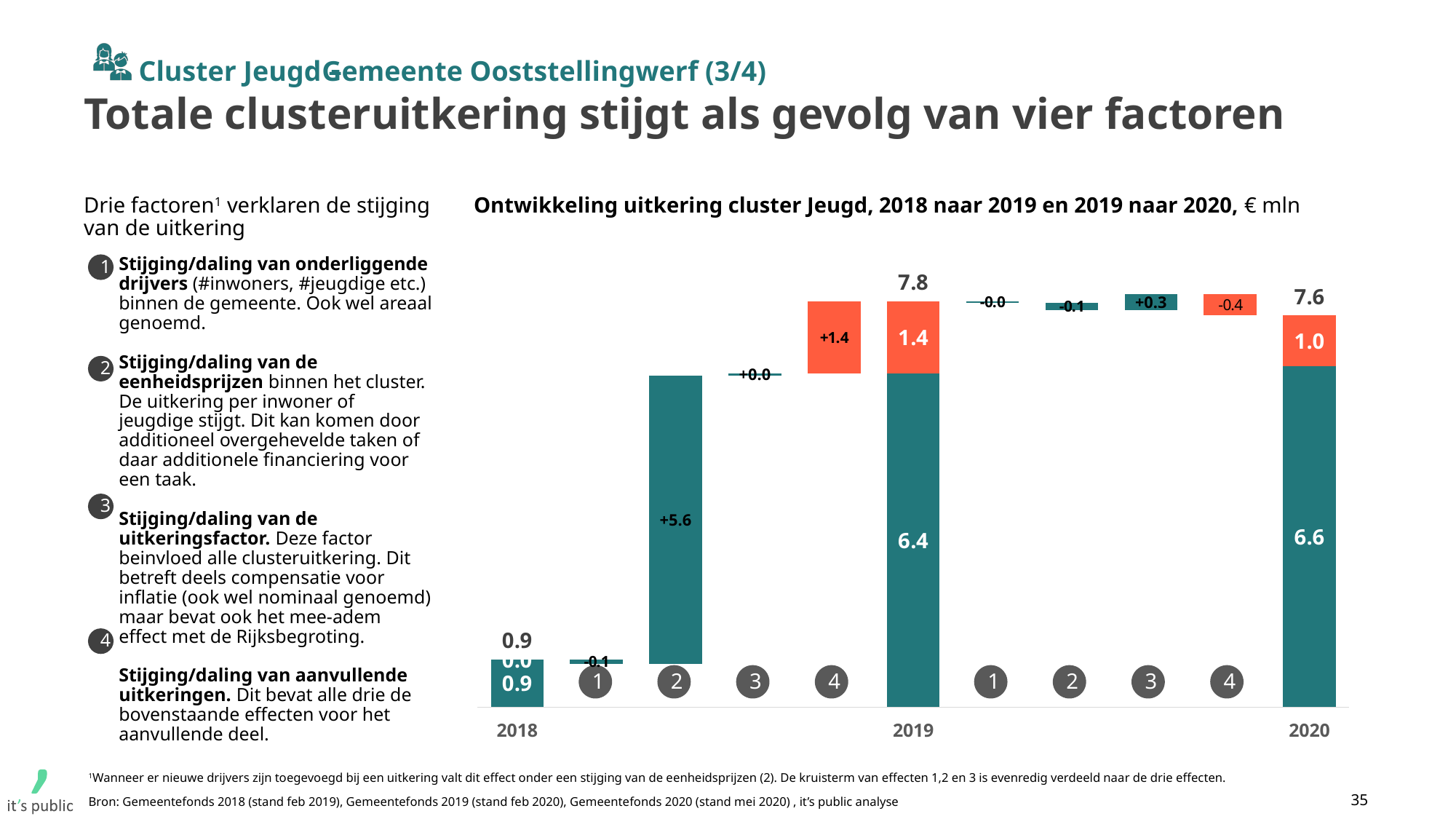
What is the total uitkering for 2018 shown in the chart? 0.9 What is the total uitkering for 2020 shown in the chart? 7.6 What is the difference between the 2019 total (7.8) and the 2020 total (7.6)? 0.2 In what unit are the values in the chart expressed, according to the chart title? € mln What is the value of the teal (lower) segment of the 2019 bar? 6.4 What is the effect of factor 4 in the change from 2019 to 2020? -0.4 What is the effect of factor 2 in the change from 2018 to 2019? +5.6 What is the effect of factor 4 in the change from 2018 to 2019? +1.4 What is the total uitkering for 2019 shown in the chart? 7.8 Which year has the higher total uitkering, 2019 or 2020? 2019 Which factor has the largest effect in the change from 2018 to 2019? Factor 2 What is the effect of factor 3 in the change from 2019 to 2020? +0.3